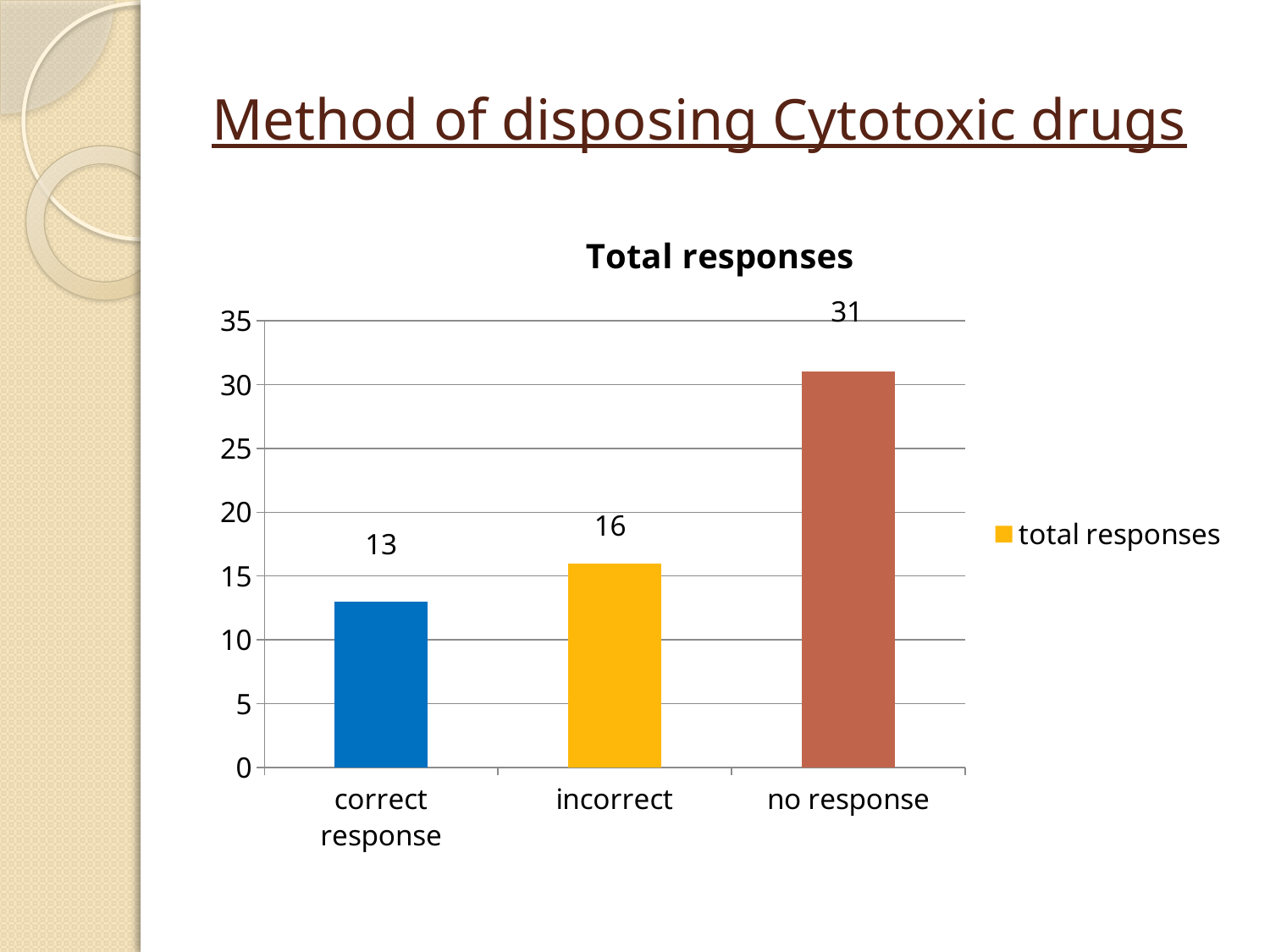
Which category has the highest value? no response What kind of chart is shown on the slide? bar chart What is the value for correct response? 13 Which category has the lowest value? correct response What is the title of the chart? Total responses How many categories are shown on the x axis? 3 What is the difference between the values for no response and incorrect? 15 What is the difference between the values for incorrect and correct response? 3 What is the value for no response? 31 Is the value for no response greater or less than 30? greater What is the value for incorrect? 16 Which is larger, the value for incorrect or the value for correct response? incorrect